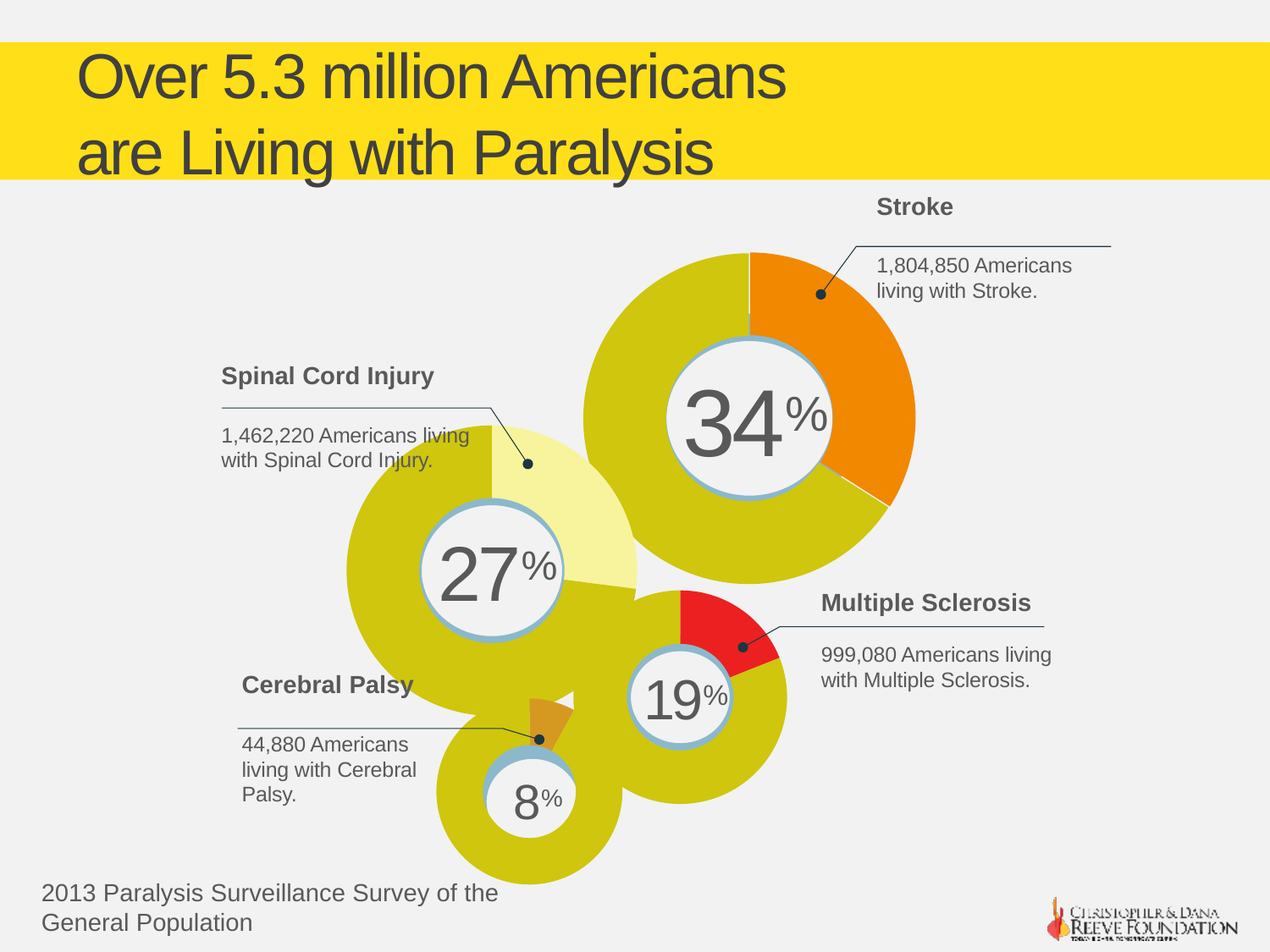
Which condition has the lowest percentage shown? Cerebral Palsy How many conditions are shown with their own donut chart on the slide? 4 What is the difference in percentage points between Stroke and Spinal Cord Injury? 7 What kind of chart is used to show each condition's percentage? Donut chart Which condition has the highest percentage shown? Stroke Which has a larger number of Americans: Multiple Sclerosis or Cerebral Palsy? Multiple Sclerosis How many more Americans are living with Stroke than with Spinal Cord Injury? 342,630 How many Americans are living with Spinal Cord Injury according to the slide? 1,462,220 What percentage is shown for Multiple Sclerosis? 19% What colour is the highlighted segment for Multiple Sclerosis? Red What percentage is shown for Stroke? 34% How many Americans are living with Cerebral Palsy according to the slide? 44,880